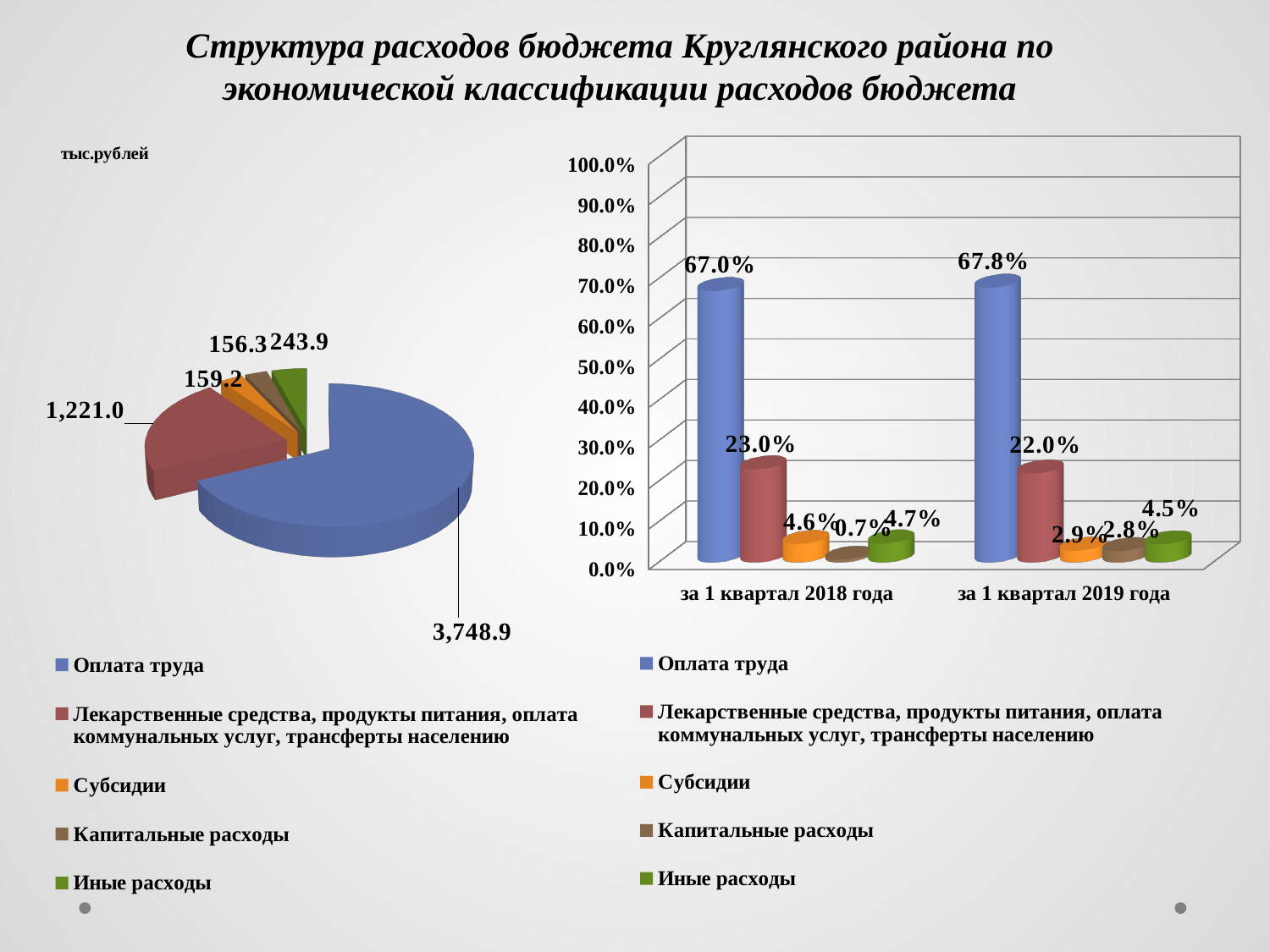
On the bar chart on the right, which is larger: Субсидии за 1 квартал 2018 года or Субсидии за 1 квартал 2019 года? за 1 квартал 2018 года On the pie chart on the left, what is the value for Оплата труда? 3,748.9 On the bar chart on the right, what is the difference between the Оплата труда values for 2019 and 2018? 0.8% On the bar chart on the right, what is the value for Капитальные расходы за 1 квартал 2018 года? 0.7% On the pie chart on the left, what unit is shown above the chart? тыс.рублей On the bar chart on the right, how many series does the legend list? 5 On the pie chart on the left, which category has the largest slice? Оплата труда What kind of chart is on the right side of the slide? Bar chart On the bar chart on the right, what is the value for Оплата труда за 1 квартал 2019 года? 67.8% On the bar chart on the right, which category has the lowest value за 1 квартал 2018 года? Капитальные расходы On the pie chart on the left, what is the value for Лекарственные средства, продукты питания, оплата коммунальных услуг, трансферты населению? 1,221.0 On the pie chart on the left, how many slices does the pie have? 5